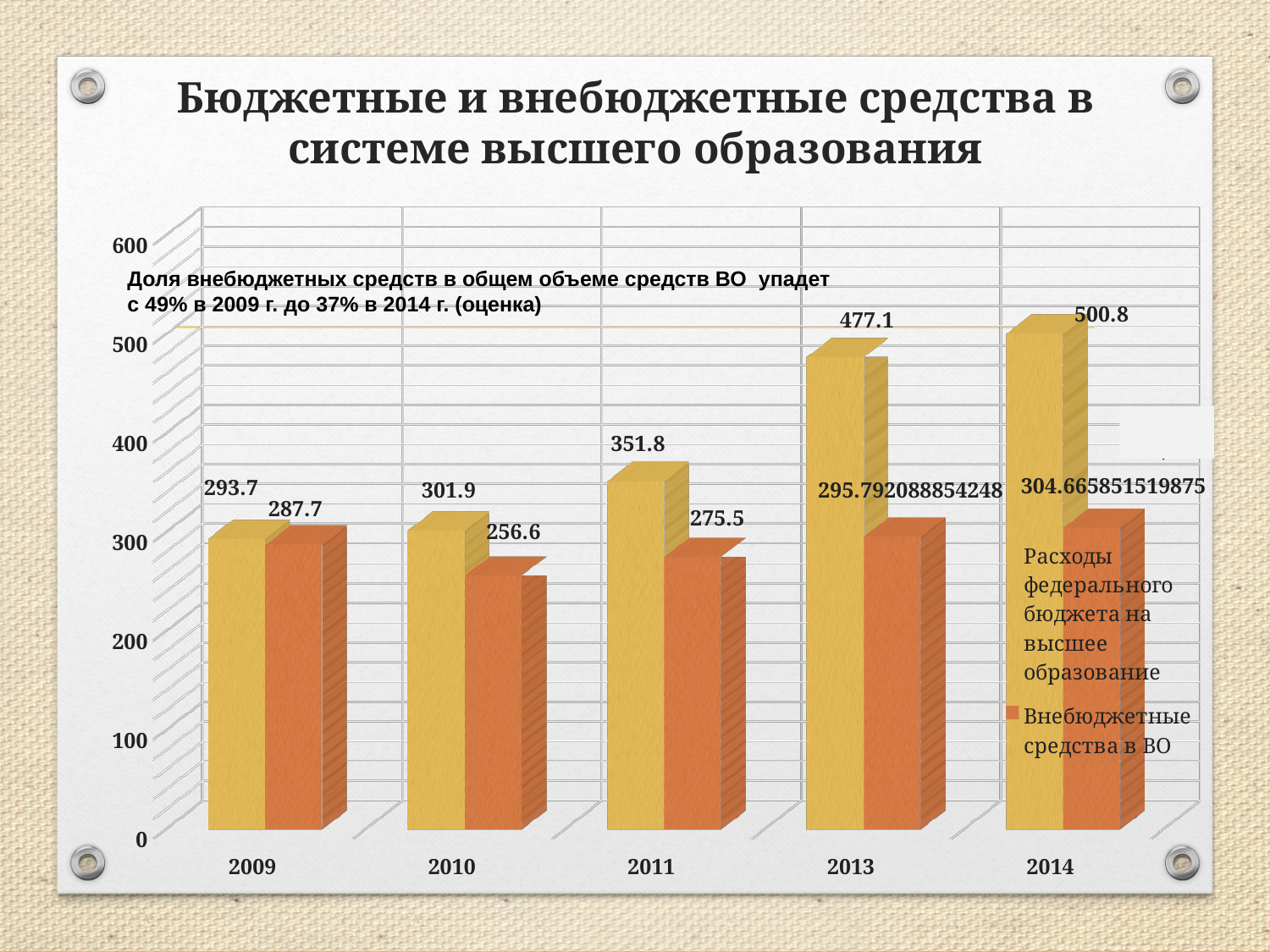
How many series does the legend list? 2 How many years are shown on the x axis? 5 In which year is Расходы федерального бюджета на высшее образование highest? 2014 Which colour represents Внебюджетные средства в ВО in the chart? orange What type of chart is shown on the slide? bar chart What is the value of Расходы федерального бюджета на высшее образование in 2014? 500.8 What is the value of Внебюджетные средства в ВО in 2010? 256.6 Which is larger in 2009: Расходы федерального бюджета на высшее образование or Внебюджетные средства в ВО? Расходы федерального бюджета на высшее образование What is the difference between Расходы федерального бюджета на высшее образование in 2013 and in 2011? 125.3 What is the value of Расходы федерального бюджета на высшее образование in 2011? 351.8 Does Расходы федерального бюджета на высшее образование rise or fall from 2009 to 2014? rise In which year is Внебюджетные средства в ВО lowest? 2010